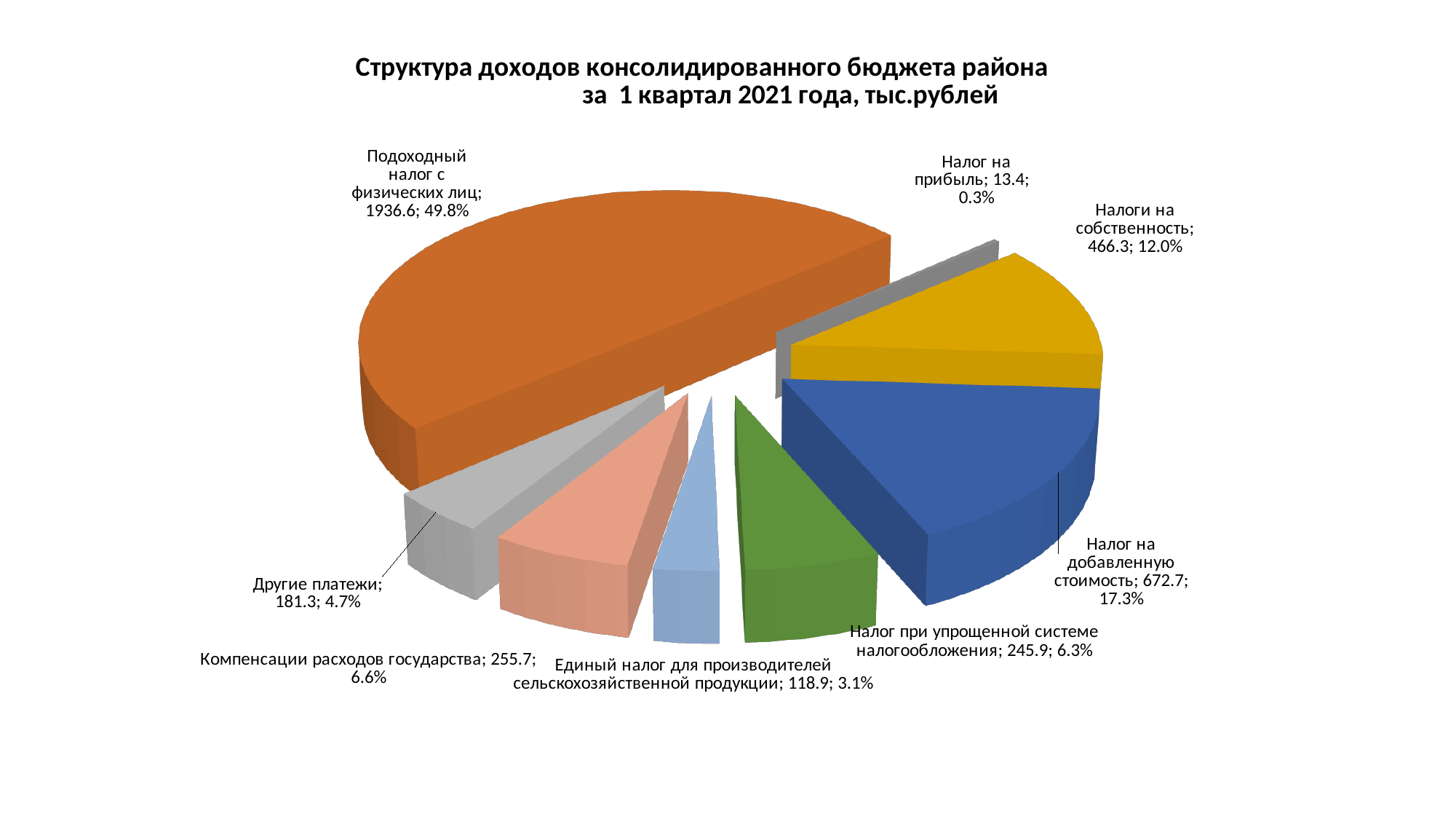
What share of the pie does "Налог на добавленную стоимость" represent? 17.3% What is the value for "Налоги на собственность"? 466.3 Which category has the largest slice of the pie? Подоходный налог с физических лиц What is the value for "Налог на добавленную стоимость"? 672.7 What is the title of the chart? Структура доходов консолидированного бюджета района за 1 квартал 2021 года, тыс.рублей Which is larger: "Компенсации расходов государства" or "Налог при упрощенной системе налогообложения"? Компенсации расходов государства What is the value for "Подоходный налог с физических лиц"? 1936.6 Which category has the smallest slice of the pie? Налог на прибыль What kind of chart is shown on the slide? pie chart What is the difference between the values for "Налог на добавленную стоимость" and "Налоги на собственность"? 206.4 What share of the pie does "Другие платежи" represent? 4.7% How many slices does the pie chart have? 8